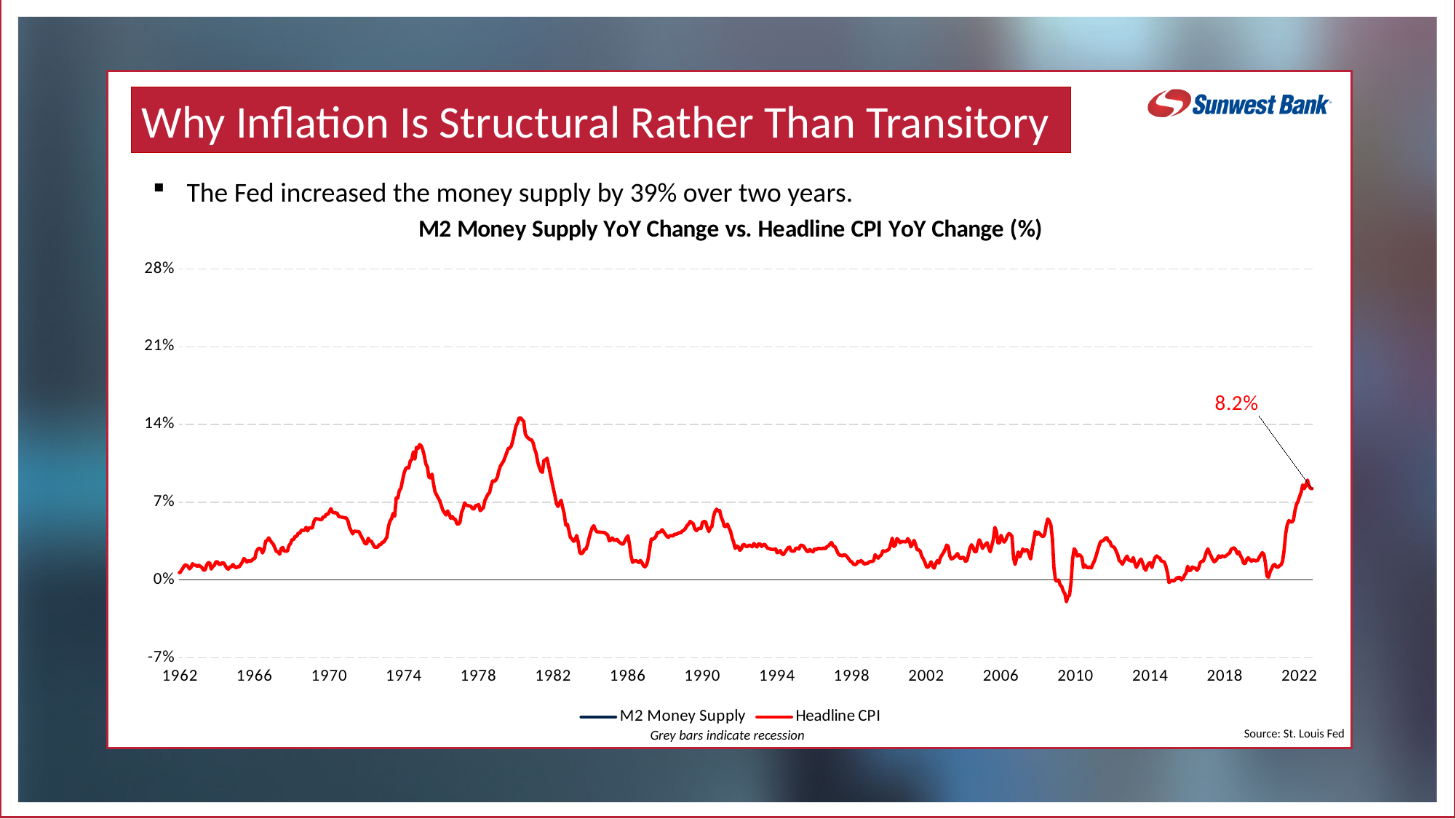
What is the title of the chart? M2 Money Supply YoY Change vs. Headline CPI YoY Change (%) Is the labelled 2022 value of Headline CPI greater or less than 7%? greater What value is labelled at the end of the Headline CPI line in 2022? 8.2% Around 2009, does the Headline CPI line fall below 0%? yes How many series does the chart legend list? 2 What is the highest value shown on the vertical axis? 28% Is the Headline CPI value at the start of the chart in 1962 greater or less than 7%? less What colour is the Headline CPI line? red Which is larger for Headline CPI: the peak around 1980 or the value in 1962? the peak around 1980 What kind of chart is shown on the slide? line chart